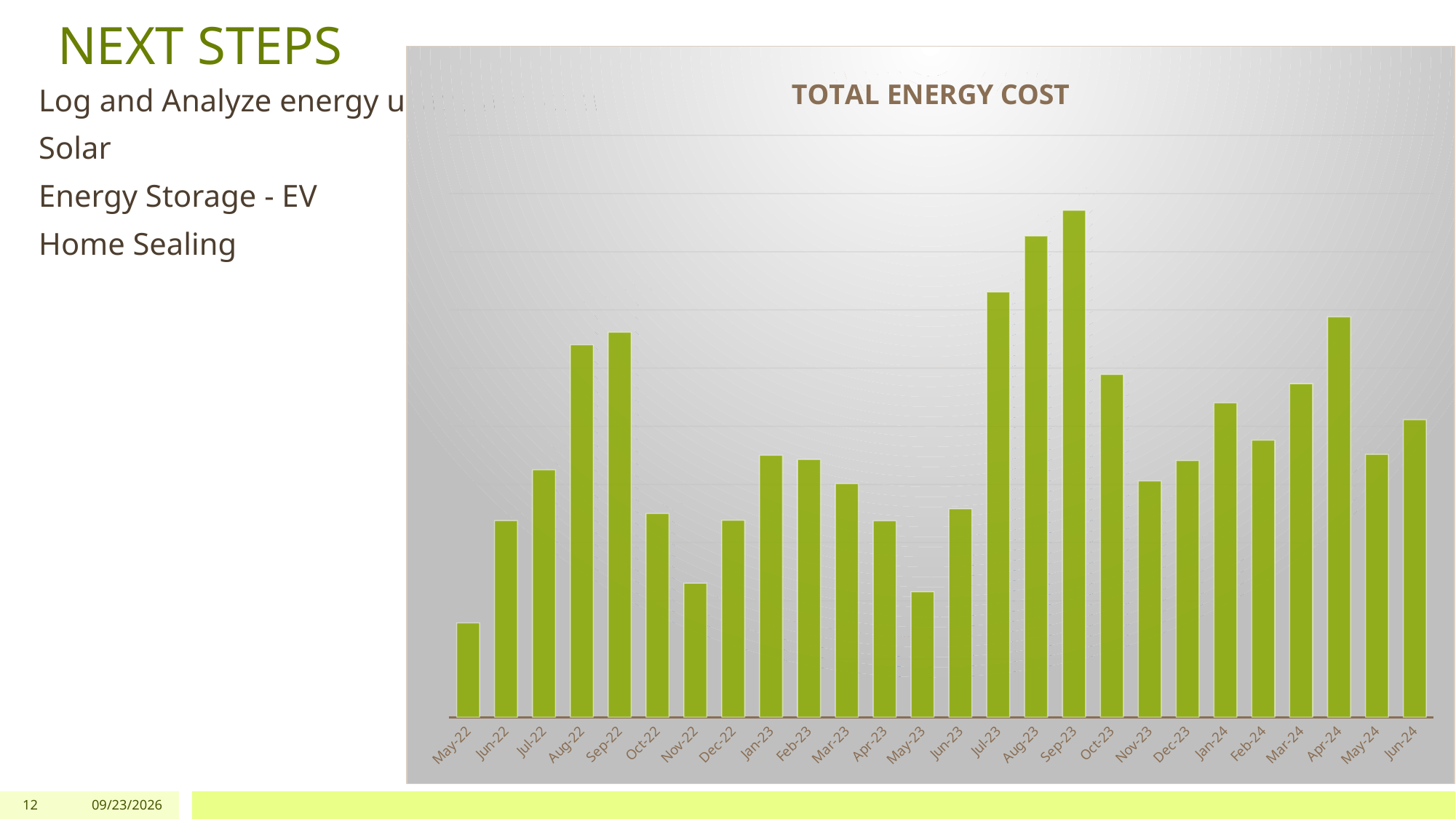
Which month has the highest total energy cost? Sep-23 Which is larger, the total energy cost for Jul-23 or Oct-23? Jul-23 Which is larger, the total energy cost for Aug-22 or Aug-23? Aug-23 What is the first month shown on the x axis? May-22 Which is larger, the total energy cost for May-24 or Jun-24? Jun-24 What is the title of the chart? TOTAL ENERGY COST How many months are plotted on the x axis of the chart? 26 What kind of chart is shown on the slide? bar chart Which month has the lowest total energy cost? May-22 Do the values rise or fall from Sep-23 to Nov-23? fall Do the values rise or fall from May-22 to Sep-22? rise